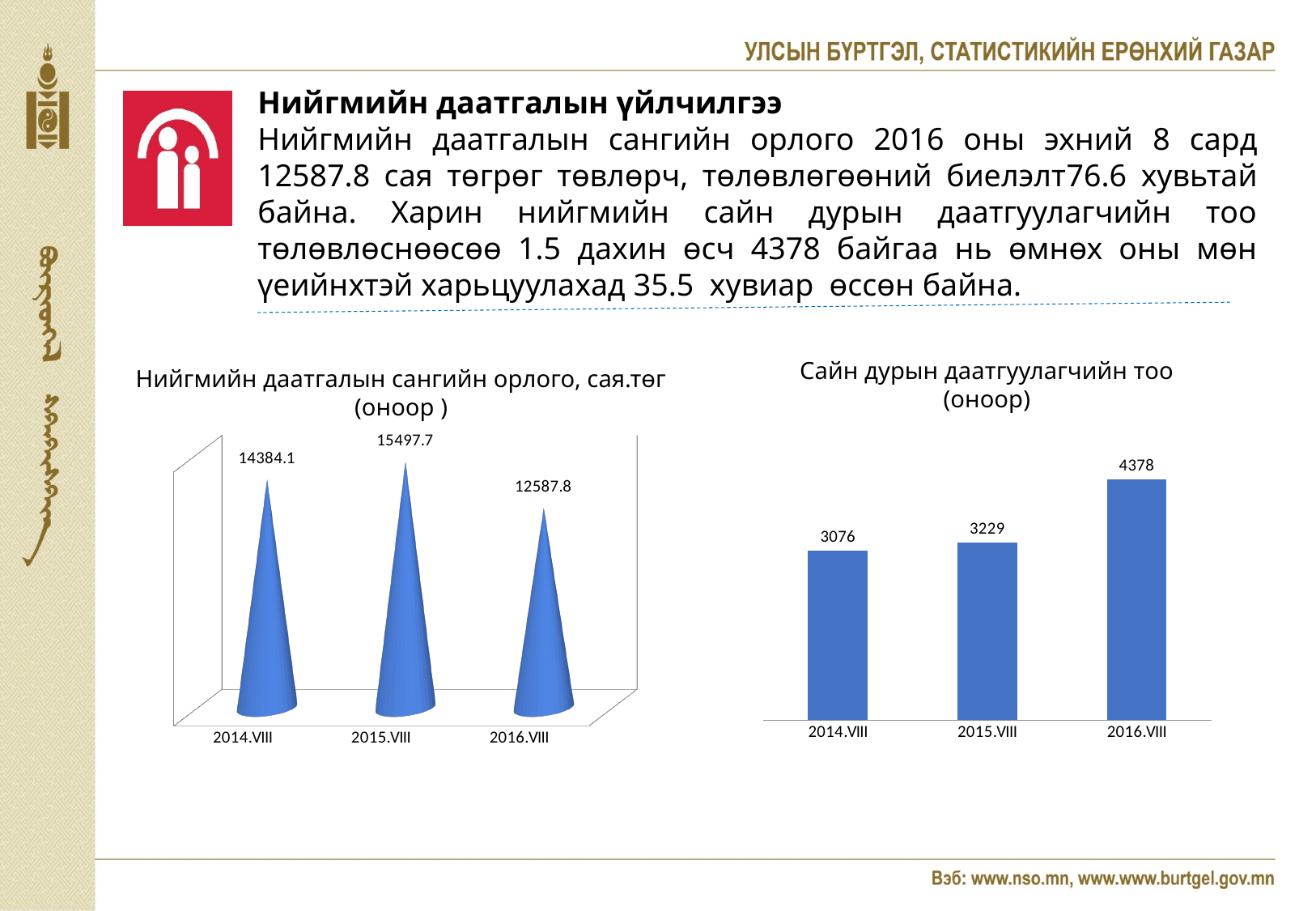
In the left chart (Нийгмийн даатгалын сангийн орлого, сая.төг), what is the difference between the values for 2015.VIII and 2014.VIII? 1113.6 In the right chart (Сайн дурын даатгуулагчийн тоо), what is the difference between the values for 2016.VIII and 2015.VIII? 1149 In the right chart (Сайн дурын даатгуулагчийн тоо), do the values rise or fall from 2014.VIII to 2016.VIII? rise In the left chart (Нийгмийн даатгалын сангийн орлого, сая.төг), what is the value for 2016.VIII? 12587.8 In the right chart (Сайн дурын даатгуулагчийн тоо), what is the value for 2016.VIII? 4378 In the right chart (Сайн дурын даатгуулагчийн тоо), which period has the highest value? 2016.VIII In the left chart (Нийгмийн даатгалын сангийн орлого, сая.төг), which period has the highest value? 2015.VIII In the left chart (Нийгмийн даатгалын сангийн орлого, сая.төг), what is the value for 2015.VIII? 15497.7 What kind of chart is the right chart (Сайн дурын даатгуулагчийн тоо)? bar chart In the right chart (Сайн дурын даатгуулагчийн тоо), what is the value for 2014.VIII? 3076 In the left chart (Нийгмийн даатгалын сангийн орлого, сая.төг), which period has the lowest value? 2016.VIII In the left chart (Нийгмийн даатгалын сангийн орлого, сая.төг), how many periods are shown? 3